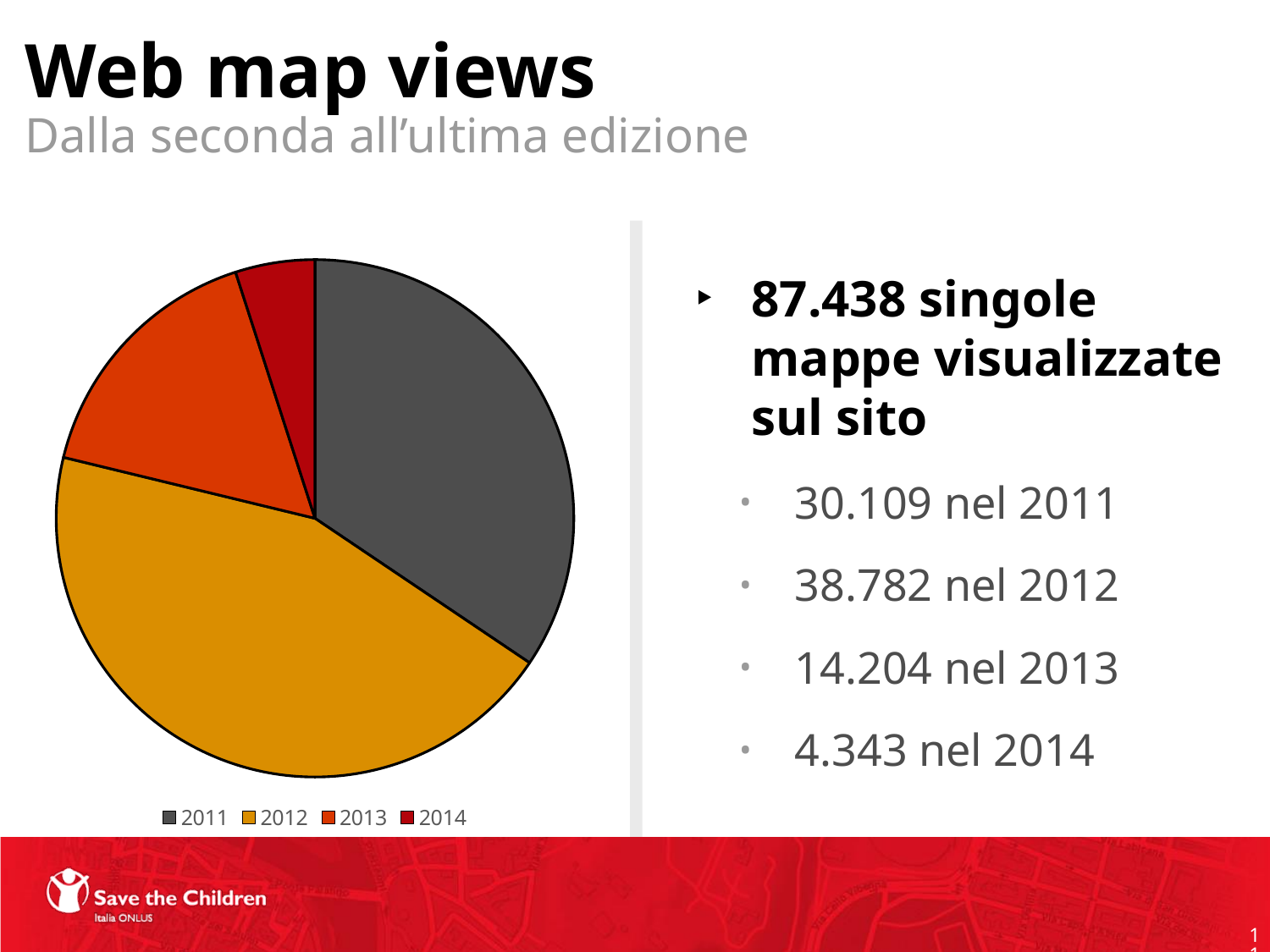
According to the slide, how many web map views were there in 2011? 30.109 Which year has the largest slice in the pie chart? 2012 What colour is the slice for 2012 in the pie chart? orange Which year has the smallest slice in the pie chart? 2014 Is the slice for 2013 larger or smaller than the slice for 2014? larger According to the slide, how many web map views were there in 2012? 38.782 Is the slice for 2011 larger or smaller than the slice for 2013? larger How many slices does the pie chart have? 4 What kind of chart is shown on the slide? pie chart How many entries does the legend of the pie chart list? 4 What is the total number of web map views across all four years shown in the pie chart? 87.438 According to the slide, how many web map views were there in 2014? 4.343